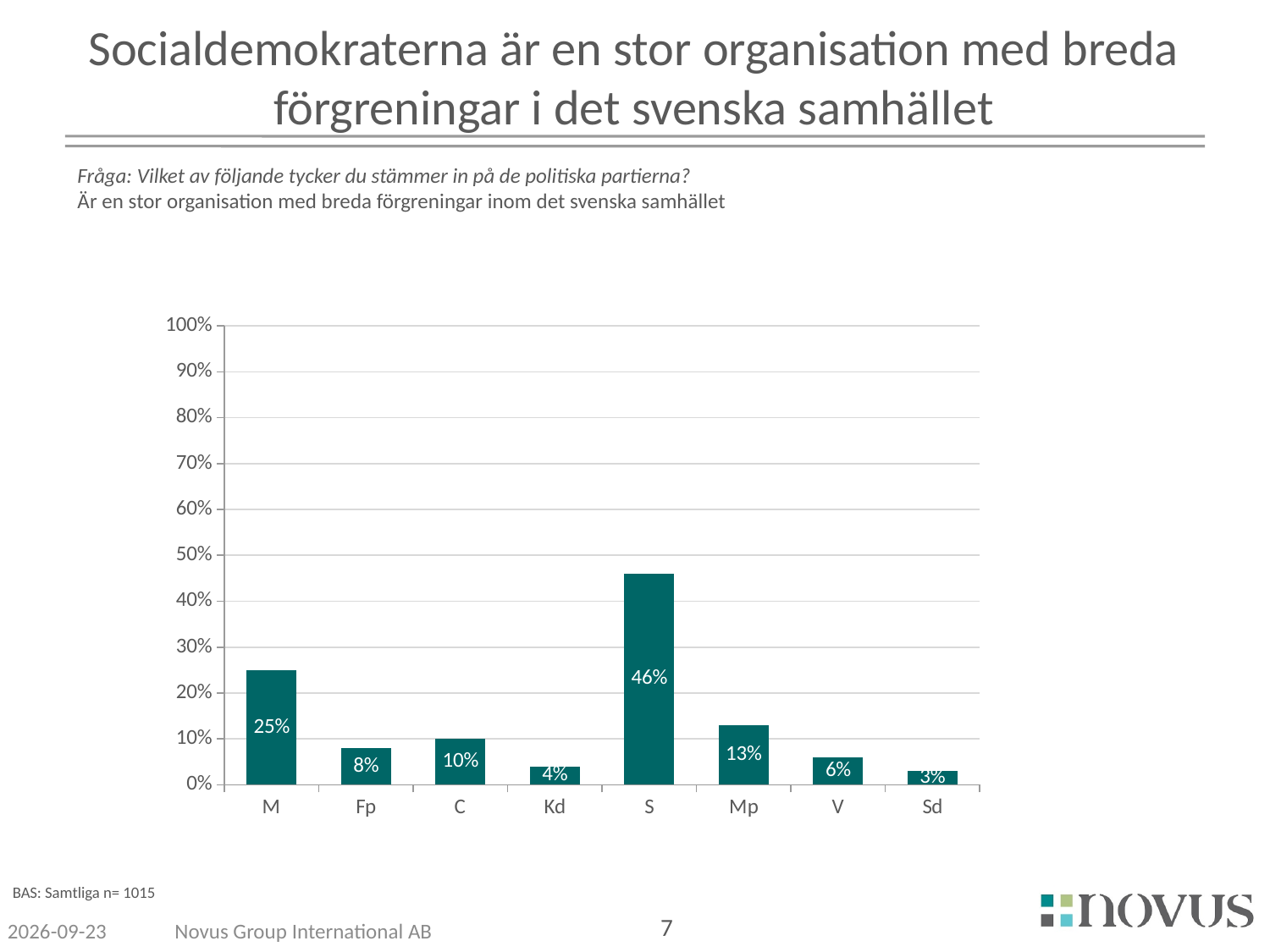
What is the value for Mp? 13% Is the value for S greater or less than 40%? greater What is the value for M? 25% Which is larger, the value for Mp or the value for C? Mp What is the difference between the values for S and M? 21% What is the value for Sd? 3% What is the difference between the values for C and Fp? 2% How many parties are shown on the x axis? 8 What is the value for S? 46% What kind of chart is shown on the slide? bar chart Which party has the lowest value? Sd Which party has the highest value? S